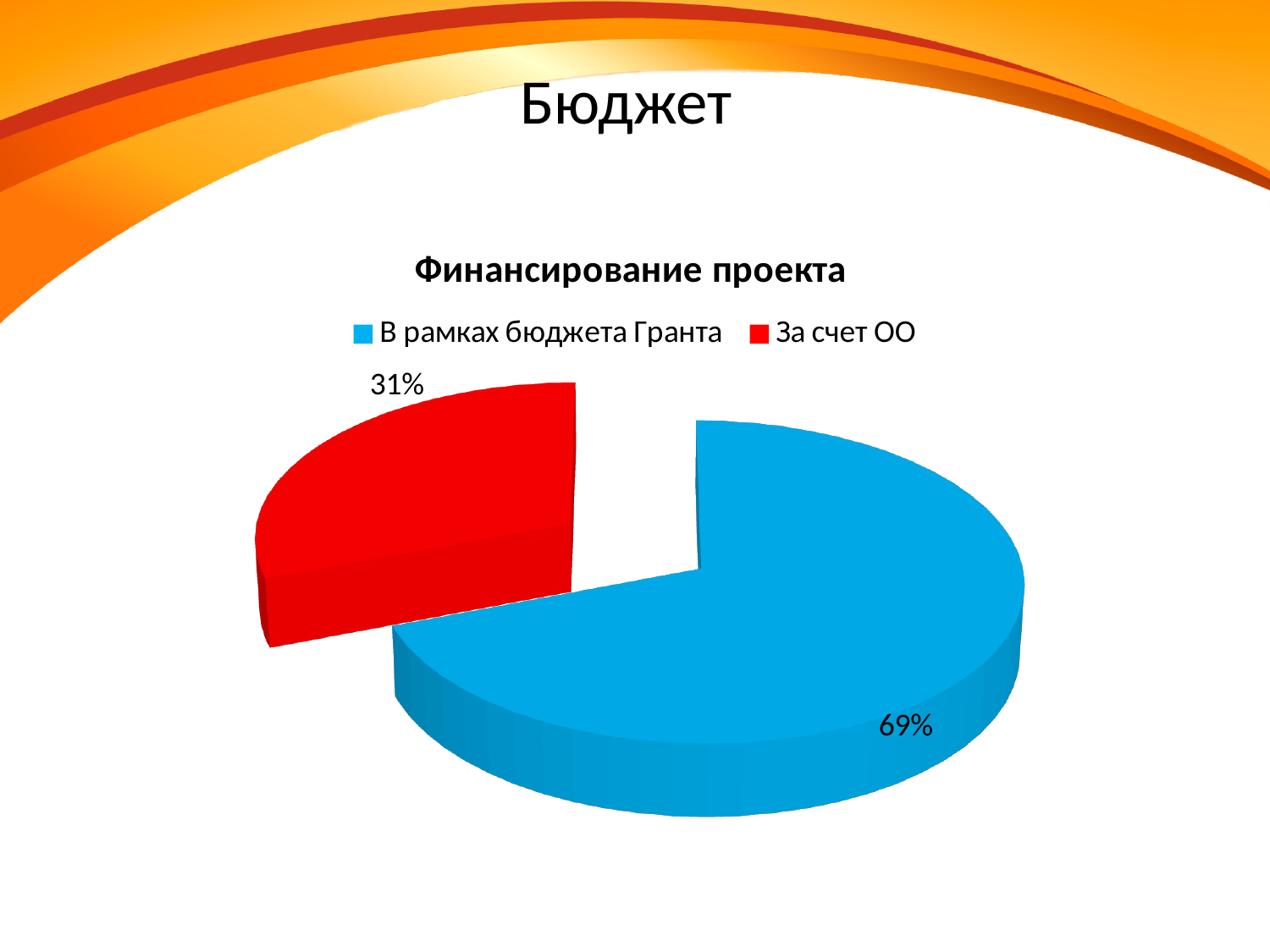
What kind of chart is shown on the slide? Pie chart Which category has the smallest slice of the pie? За счет ОО Which is larger: the share for "В рамках бюджета Гранта" or the share for "За счет ОО"? В рамках бюджета Гранта What colour is the slice for "За счет ОО"? Red How many slices does the pie chart have? 2 Which category has the largest slice of the pie? В рамках бюджета Гранта What share of the pie does "За счет ОО" represent? 31% What is the title of the chart? Финансирование проекта What is the difference in percentage points between the "В рамках бюджета Гранта" slice and the "За счет ОО" slice? 38 What share of the pie does "В рамках бюджета Гранта" represent? 69% How many entries does the legend list? 2